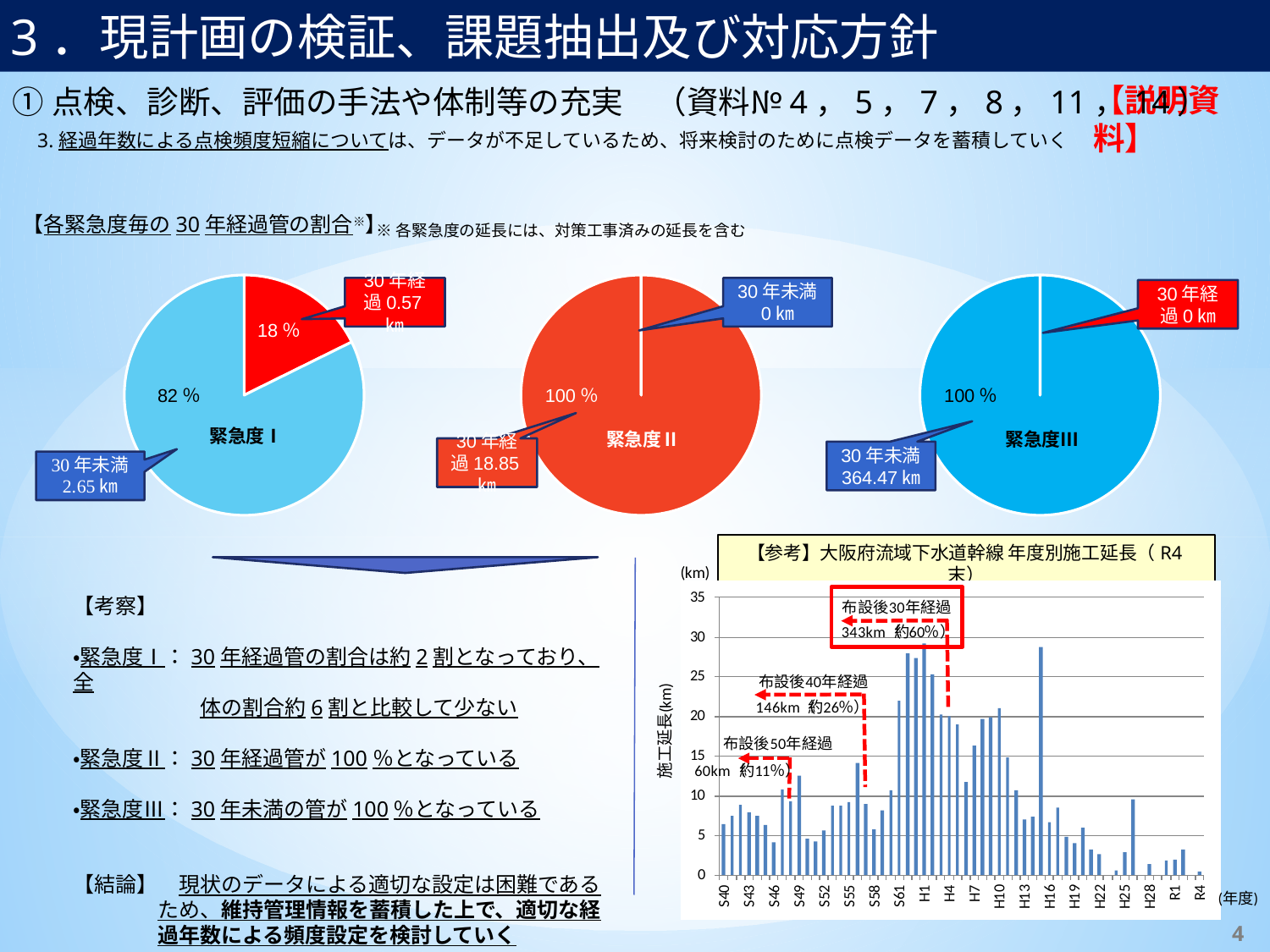
In the 年度別施工延長 bar chart, is the value for H16 greater or less than 25? greater What kind of chart is the 大阪府流域下水道幹線 年度別施工延長 chart at the bottom right? bar chart In the 緊急度 III pie chart, what is the length of the 30 年未満 pipes? 364.47 km In the 緊急度 I pie chart, what percentage of the pipes are 30 年経過? 18 % In the 緊急度 II pie chart, what is the length of the 30 年経過 pipes? 18.85 km How many pie charts are shown on the slide? 3 In the 緊急度 I pie chart, what is the difference in percentage points between the 30 年未満 and 30 年経過 slices? 64 In the 緊急度 II pie chart, what share of the pie is 30 年経過? 100 % In the 緊急度 I pie chart, what is the length of the 30 年経過 pipes? 0.57 km In the 緊急度 I pie chart, which slice is larger, 30 年未満 or 30 年経過? 30 年未満 In the 年度別施工延長 bar chart, is the value for R4 greater or less than 5? less In the 緊急度 I pie chart, what is the length of the 30 年未満 pipes? 2.65 km